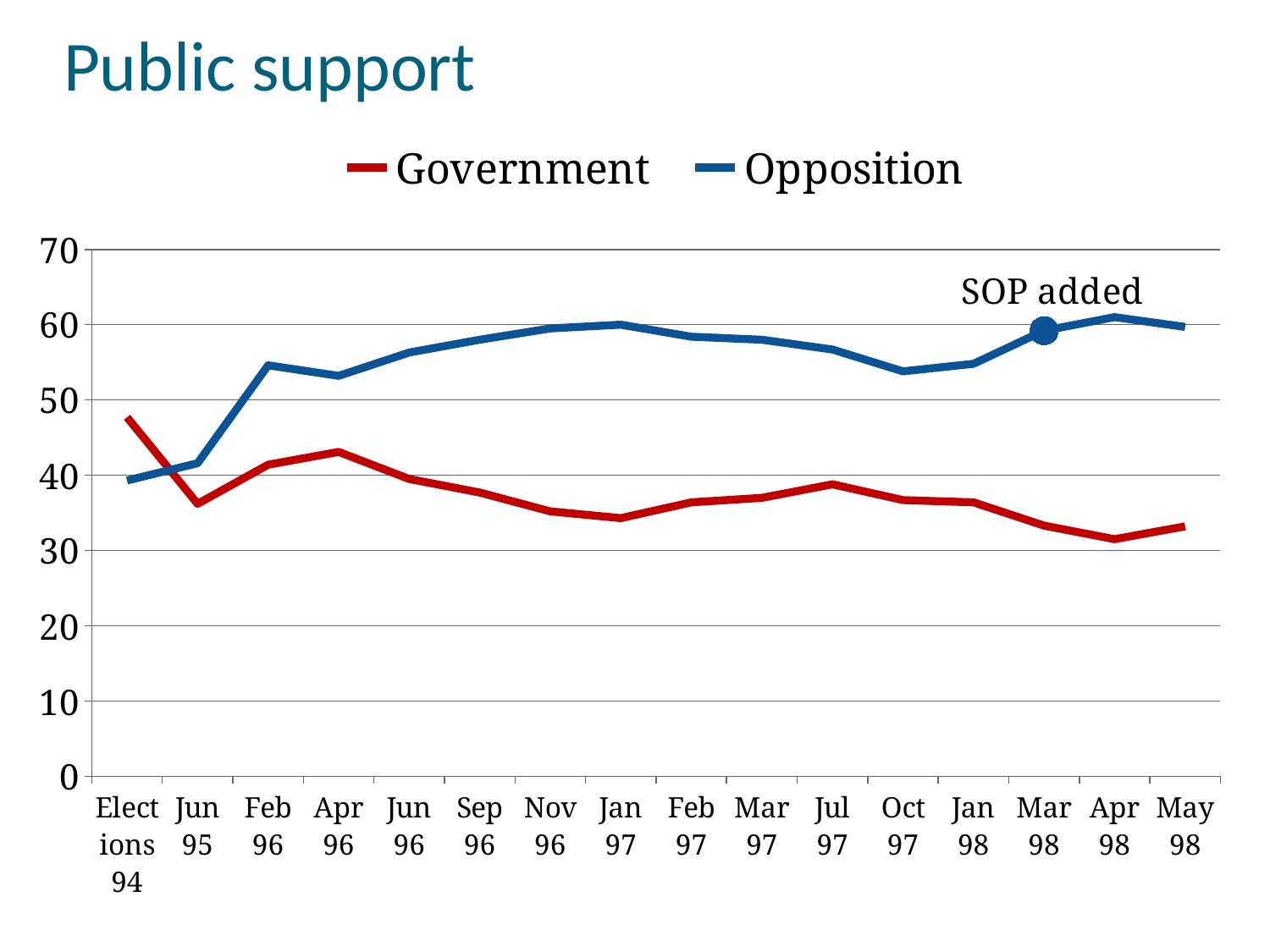
How many series does the legend list? 2 What annotation is attached to the Opposition point at Mar 98? SOP added Is the Opposition value at Feb 96 greater or less than 50? greater Is the Government value at Elections 94 greater or less than 40? greater At which point is the Opposition series lowest? Elections 94 How many points are plotted along the x axis for each series? 16 At May 98, which series has the higher value, Government or Opposition? Opposition What kind of chart is shown on the slide? line chart At Elections 94, which series has the higher value, Government or Opposition? Government At which point is the Government series highest? Elections 94 Does the Government series rise or fall from Apr 96 to Jan 97? fall Is the Government value at Jan 97 greater or less than 40? less